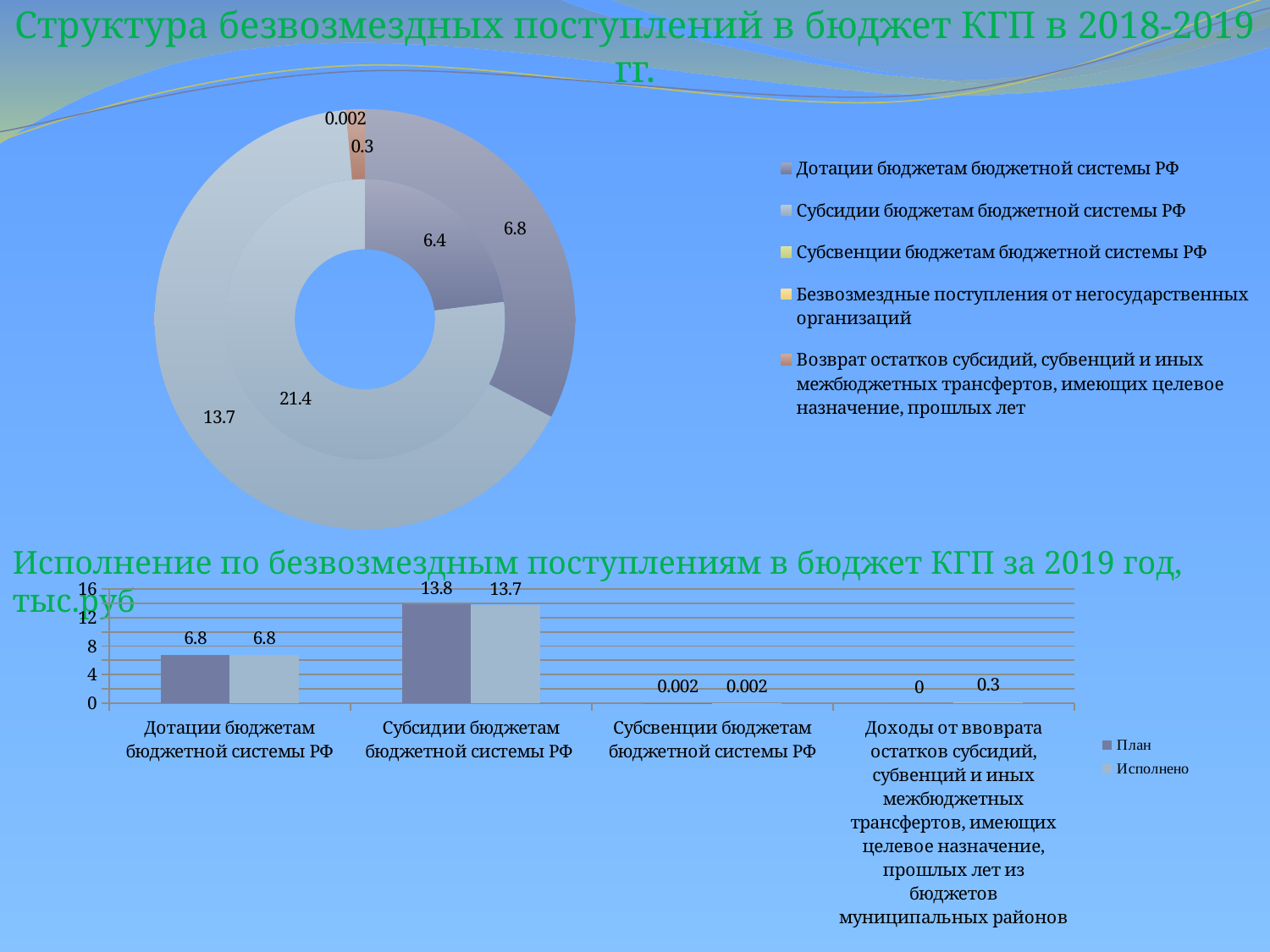
What kind of chart is the lower chart, 'Исполнение по безвозмездным поступлениям в бюджет КГП за 2019 год'? bar chart In the lower bar chart, what is the 'План' value for 'Субсидии бюджетам бюджетной системы РФ'? 13.8 In the lower bar chart, which category has the highest 'План' value? Субсидии бюджетам бюджетной системы РФ In the upper doughnut chart, how many entries does the legend list? 5 In the lower bar chart, what is the 'Исполнено' value for 'Доходы от вовврата остатков субсидий, субвенций и иных межбюджетных трансфертов'? 0.3 In the lower bar chart, how many series does the legend list? 2 In the lower bar chart, how many categories are shown on the x axis? 4 In the lower bar chart, which is larger: the 'План' value for 'Дотации бюджетам бюджетной системы РФ' or for 'Субсидии бюджетам бюджетной системы РФ'? Субсидии бюджетам бюджетной системы РФ In the lower bar chart, what is the 'Исполнено' value for 'Субсидии бюджетам бюджетной системы РФ'? 13.7 In the lower bar chart, what is the 'План' value for 'Доходы от вовврата остатков субсидий, субвенций и иных межбюджетных трансфертов'? 0 What kind of chart is the upper chart, 'Структура безвозмездных поступлений в бюджет КГП в 2018-2019 гг.'? doughnut chart In the lower bar chart, what is the difference between the 'План' and 'Исполнено' values for 'Субсидии бюджетам бюджетной системы РФ'? 0.1